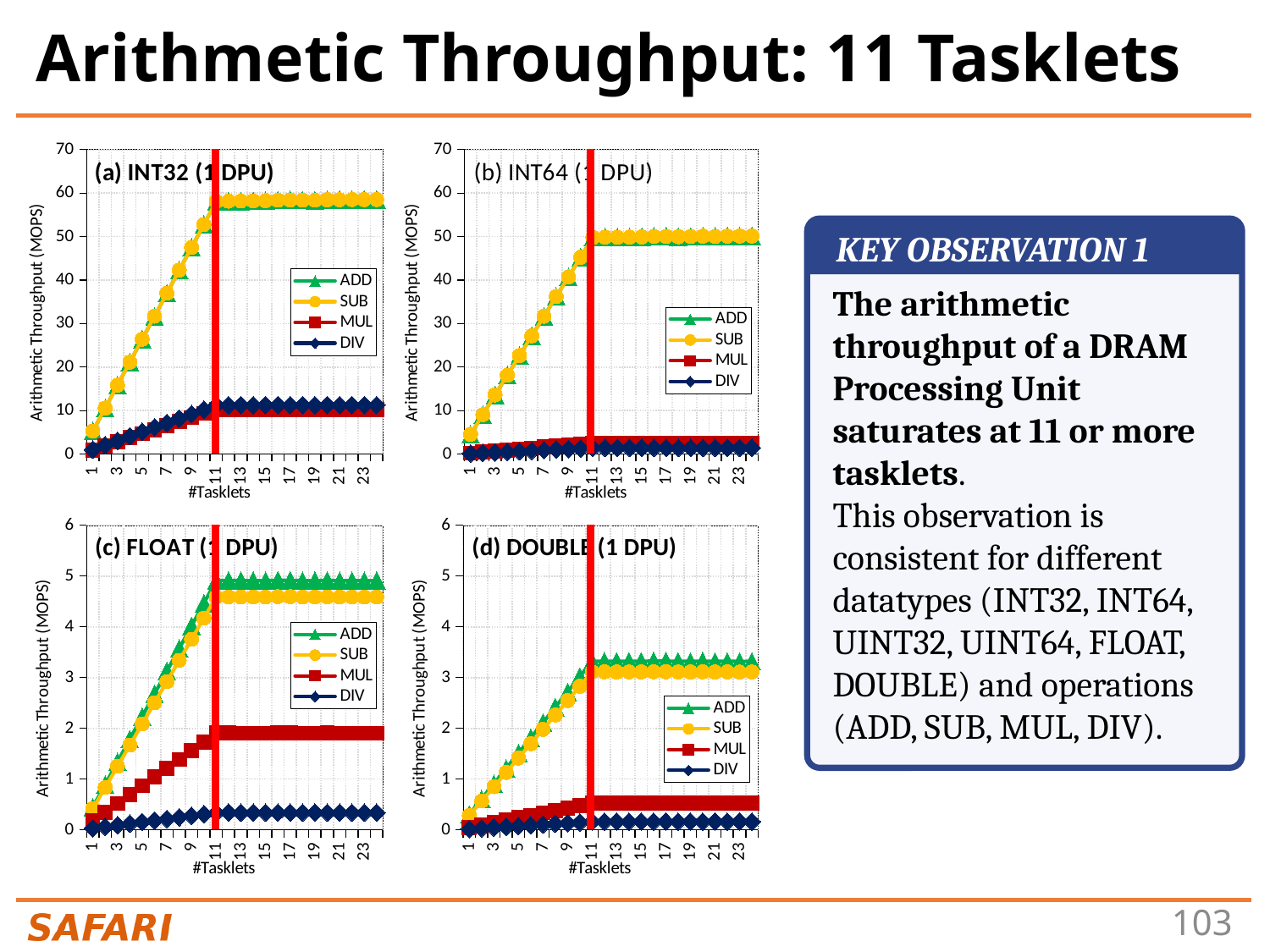
In the chart titled "(b) INT64 (1 DPU)", is the MUL value at 23 tasklets greater or less than 10? less In the chart titled "(a) INT32 (1 DPU)", does the ADD series rise or fall as the number of tasklets increases from 1 to 11? rise In the chart titled "(a) INT32 (1 DPU)", is the ADD value at 23 tasklets greater or less than 50? greater In the chart titled "(a) INT32 (1 DPU)", is the DIV value at 23 tasklets greater or less than 20? less In the chart titled "(c) FLOAT (1 DPU)", which is larger at 23 tasklets, MUL or DIV? MUL What kind of chart is the chart titled "(a) INT32 (1 DPU)"? line chart What is the y-axis label of the chart titled "(b) INT64 (1 DPU)"? Arithmetic Throughput (MOPS) In the chart titled "(a) INT32 (1 DPU)", how many series does the legend list? 4 In the chart titled "(c) FLOAT (1 DPU)", which series are listed in the legend? ADD, SUB, MUL, DIV